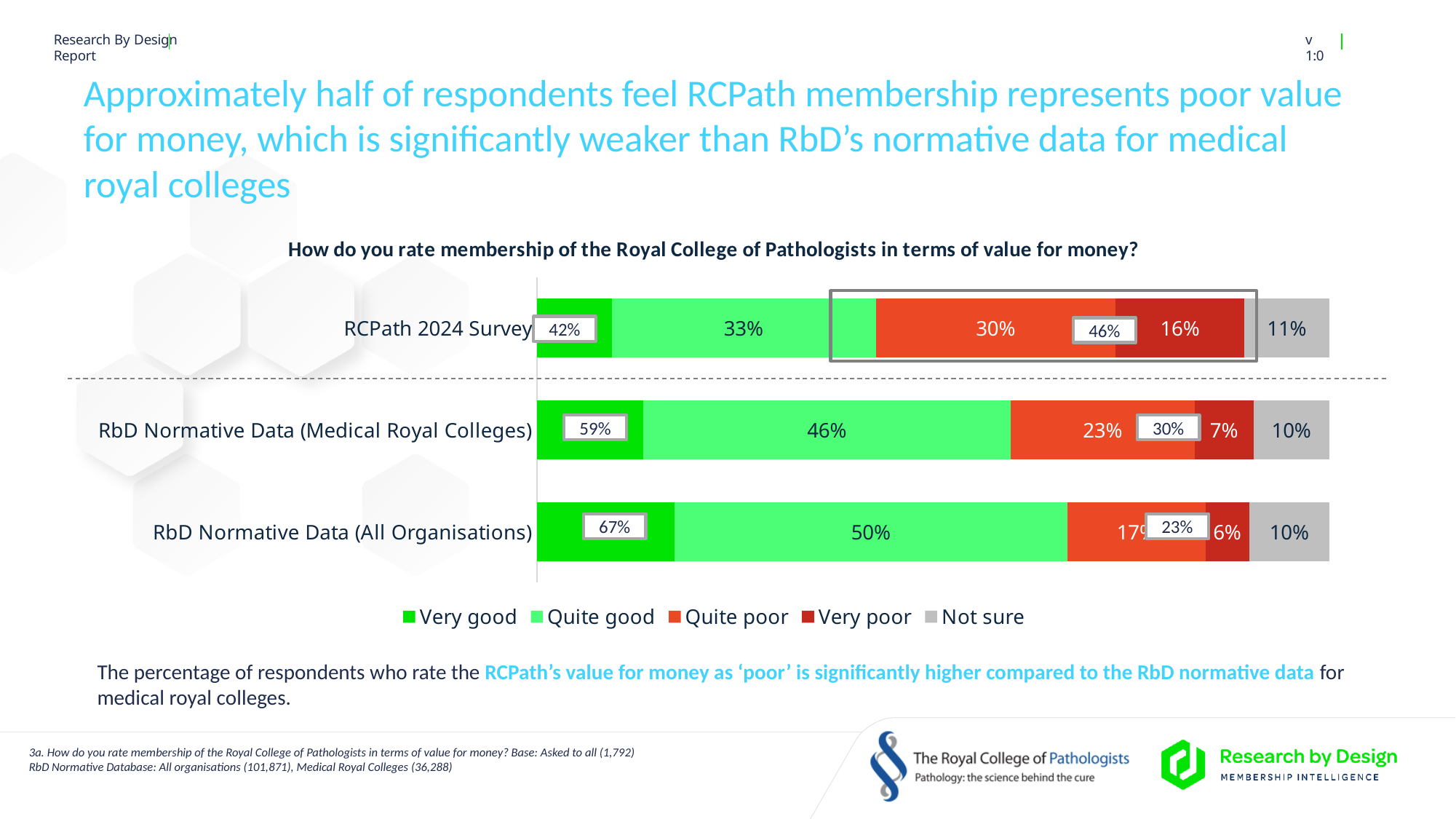
What is the 'Quite good' value for RbD Normative Data (All Organisations)? 50% How many series does the legend list? 5 Which is larger: the 'Very poor' value for RCPath 2024 Survey or for RbD Normative Data (All Organisations)? RCPath 2024 Survey How many categories (bars) are plotted in the chart? 3 Which category has the lowest 'Quite good' value? RCPath 2024 Survey What is the 'Quite poor' value for RCPath 2024 Survey? 30% What is the 'Very poor' value for RbD Normative Data (Medical Royal Colleges)? 7% What is the difference between the 'Quite good' values for RbD Normative Data (Medical Royal Colleges) and RCPath 2024 Survey? 13% What type of chart is shown on the slide? Stacked bar chart What is the 'Not sure' value for RCPath 2024 Survey? 11% Which category has the highest 'Very poor' value? RCPath 2024 Survey What is the 'Quite good' value for RCPath 2024 Survey? 33%